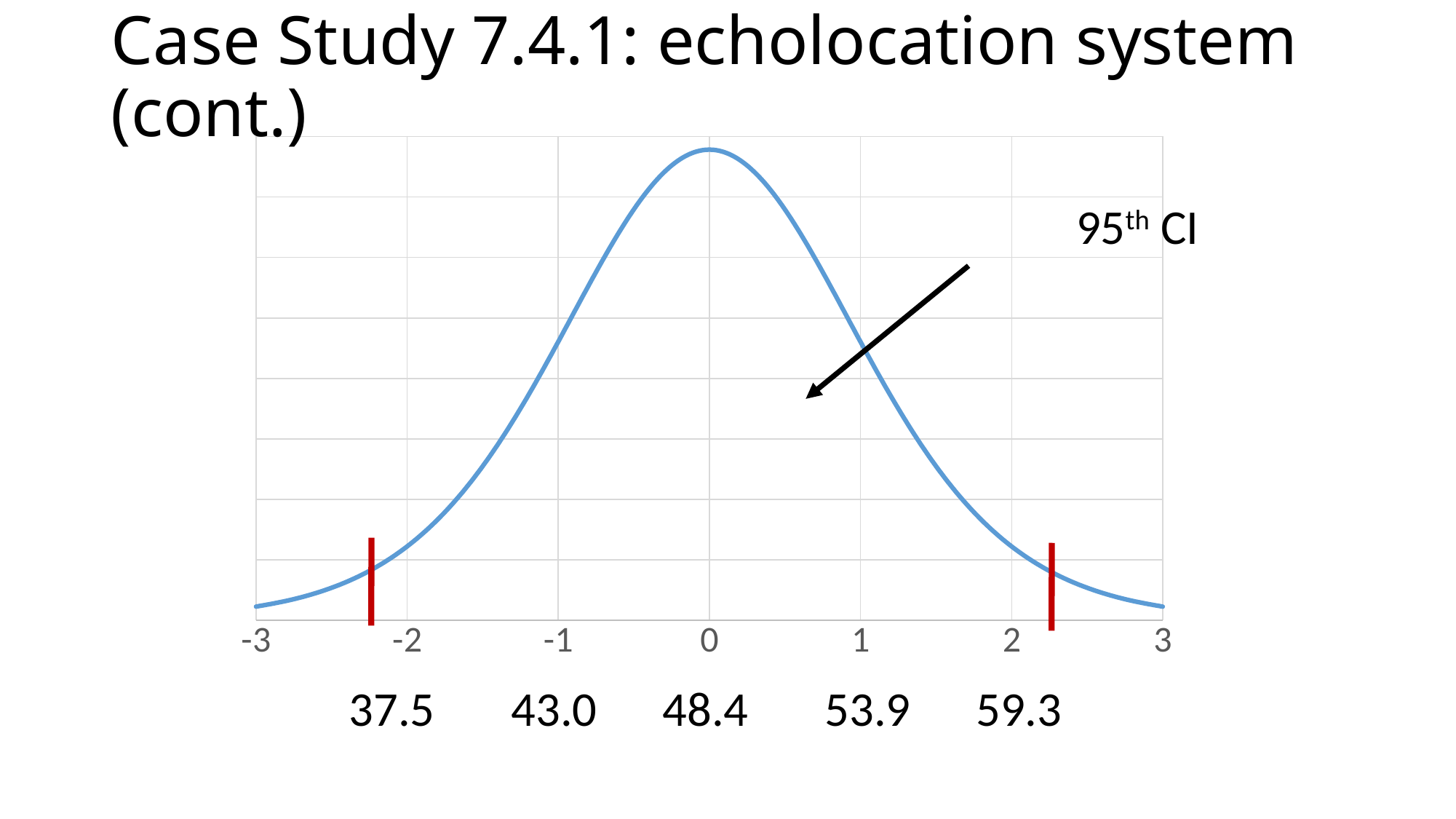
What value is printed beneath the x-axis tick 0? 48.4 What is the difference between the values printed beneath the x-axis ticks 2 and -2 (59.3 and 37.5)? 21.8 At which x-axis value does the curve reach its highest point? 0 How many tick labels are shown on the x axis from -3 to 3? 7 Does the curve rise or fall as x goes from -3 to 0? rise What value is printed beneath the x-axis tick -2? 37.5 Is the curve higher at x = -1 or at x = -2? -1 What value is printed beneath the x-axis tick 2? 59.3 What kind of chart is shown on the slide? line chart What does the arrow annotation on the chart point to, according to its label? 95th CI Does the curve rise or fall as x goes from 0 to 3? fall Is the curve higher at x = 1 or at x = 2? 1